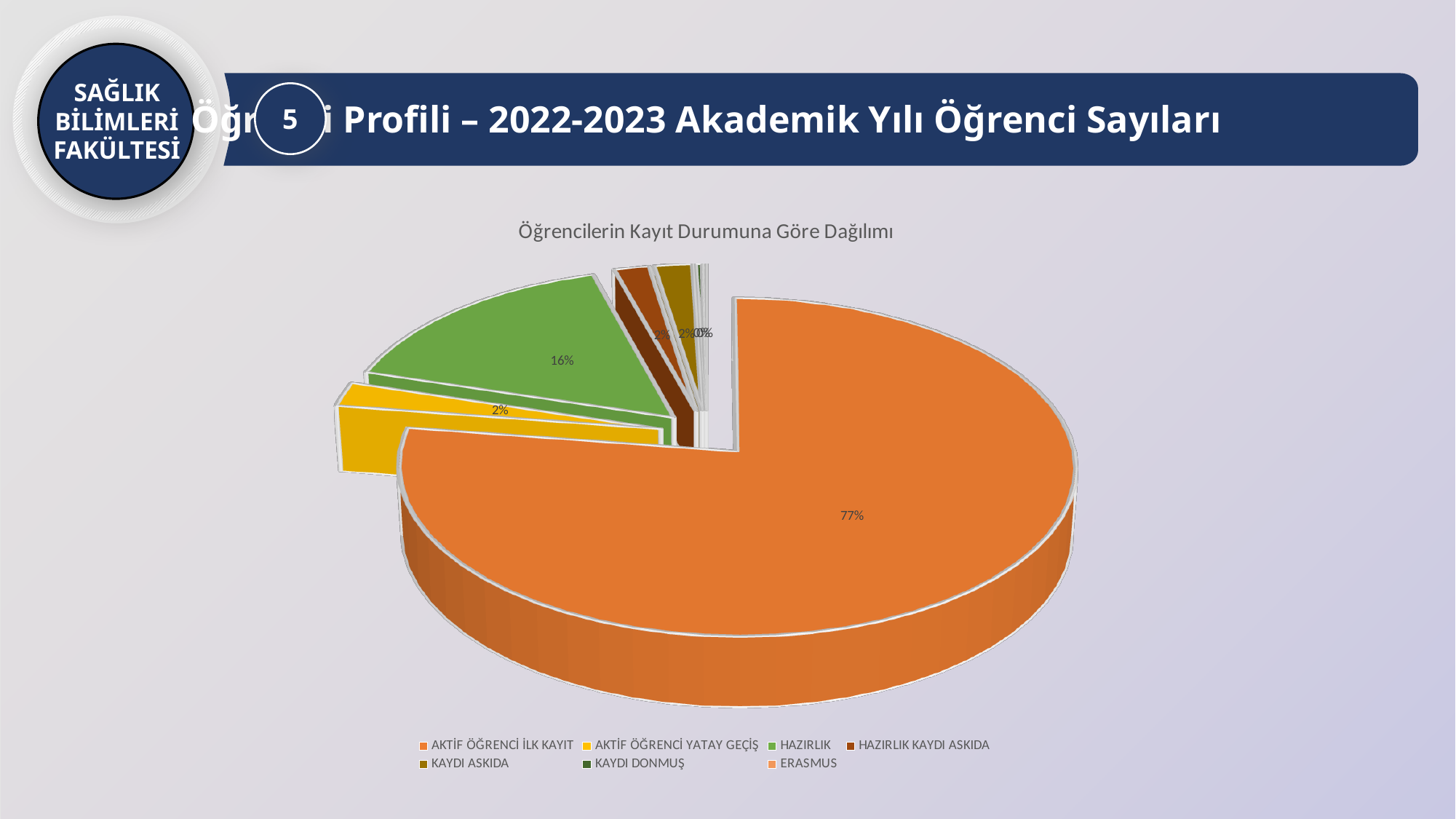
Which is larger, the HAZIRLIK slice or the AKTİF ÖĞRENCİ YATAY GEÇİŞ slice? HAZIRLIK What colour is the largest slice of the pie? Orange How many categories does the legend of the pie chart list? 7 What share of the pie does HAZIRLIK represent? 16% What share of the pie does AKTİF ÖĞRENCİ İLK KAYIT represent? 77% What is the title of the chart? Öğrencilerin Kayıt Durumuna Göre Dağılımı Is the share for AKTİF ÖĞRENCİ İLK KAYIT greater or less than 50%? greater What kind of chart is shown on the slide? Pie chart What percentage is shown for AKTİF ÖĞRENCİ YATAY GEÇİŞ? 2% Which category has the largest slice of the pie? AKTİF ÖĞRENCİ İLK KAYIT What is the difference in percentage points between AKTİF ÖĞRENCİ İLK KAYIT and HAZIRLIK? 61 percentage points Which category has the second-largest slice of the pie? HAZIRLIK